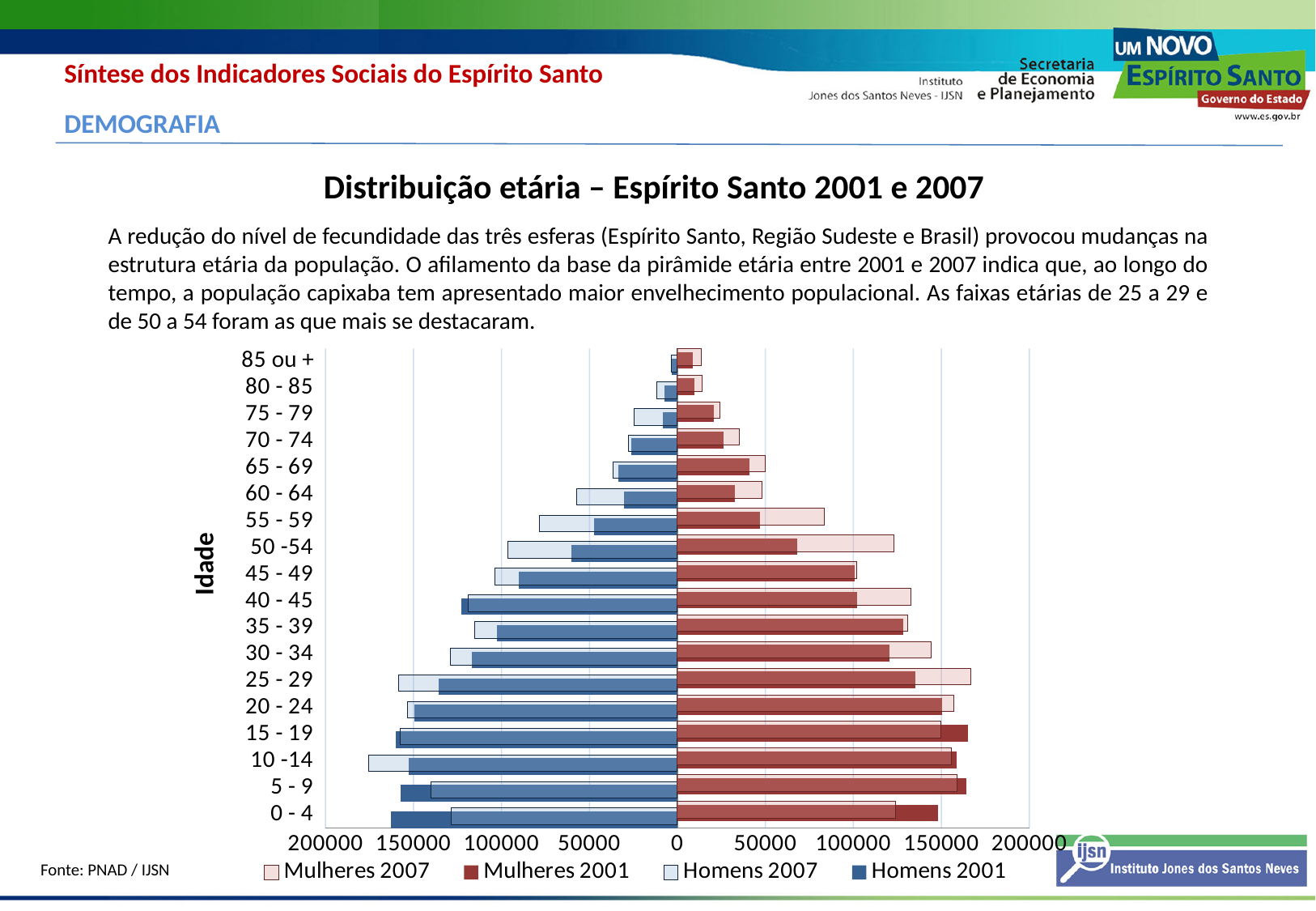
For the 50 -54 age group, which is larger: Mulheres 2007 or Mulheres 2001? Mulheres 2007 Is the value for Homens 2007 in the 10 -14 age group greater or less than 150000? greater What is the title of the chart? Distribuição etária – Espírito Santo 2001 e 2007 How many age groups are shown on the vertical axis? 18 Is the value for Mulheres 2001 in the 65 - 69 age group greater or less than 50000? less How many series does the legend list? 4 Is the value for Homens 2001 in the 50 -54 age group greater or less than 50000? greater Which age group has the lowest value for Mulheres 2001? 85 ou + Which age group has the highest value for Homens 2007? 10 -14 What kind of chart is shown on the slide? bar chart What is the label of the vertical axis? Idade